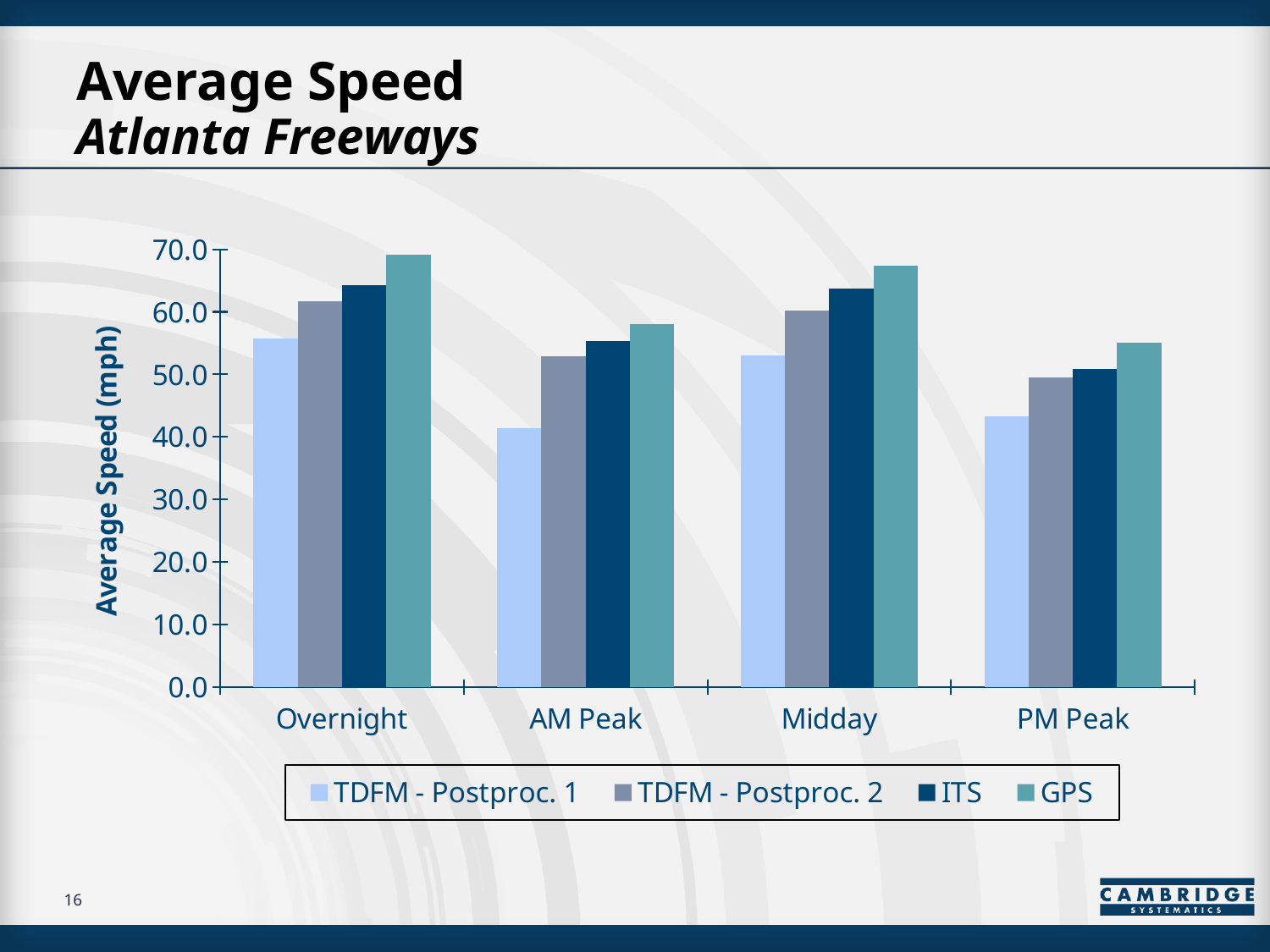
What kind of chart is shown on the slide? bar chart Is the TDFM - Postproc. 1 value for PM Peak greater or less than 50? less Which is larger, the ITS value for Overnight or the ITS value for PM Peak? Overnight What is the title of the vertical axis? Average Speed (mph) In which time period is the GPS average speed highest? Overnight In which time period is the GPS average speed lowest? PM Peak How many time-period categories are shown on the x axis? 4 Which series has the highest value in the AM Peak period? GPS Is the TDFM - Postproc. 1 value for AM Peak greater or less than 50? less Is the GPS value for Overnight greater or less than 60? greater How many series does the legend list? 4